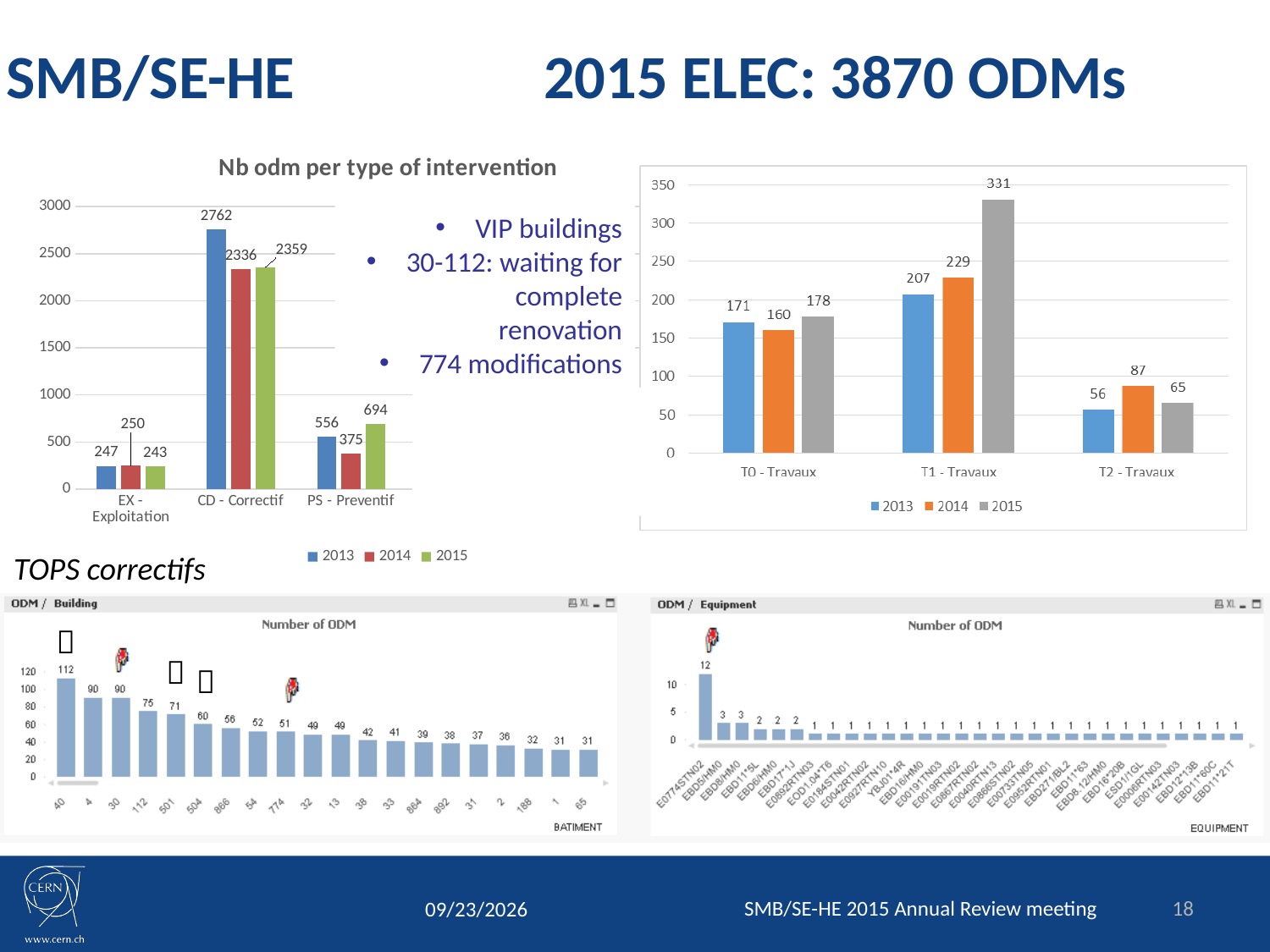
In the 'Nb odm per type of intervention' chart, what is the 2013 value for CD - Correctif? 2762 What kind of chart is the 'ODM / Equipment' chart? bar chart In the top-right chart (T0/T1/T2 Travaux), how many categories are shown on the x axis? 3 In the 'Nb odm per type of intervention' chart, how many series does the legend list? 3 In the top-right chart (T0/T1/T2 Travaux), what is the difference between the 2015 and 2013 values for T1 - Travaux? 124 In the 'ODM / Building' chart, what is the highest value shown? 112 In the 'Nb odm per type of intervention' chart, what is the difference between the 2013 and 2014 values for CD - Correctif? 426 In the 'Nb odm per type of intervention' chart, which category has the lowest 2014 value? EX - Exploitation In the top-right chart (T0/T1/T2 Travaux), which is larger for T2 - Travaux: the 2014 value or the 2015 value? 2014 In the top-right chart (T0/T1/T2 Travaux), what is the 2015 value for T1 - Travaux? 331 In the 'Nb odm per type of intervention' chart, what is the 2015 value for PS - Preventif? 694 In the top-right chart (T0/T1/T2 Travaux), what is the 2014 value for T0 - Travaux? 160